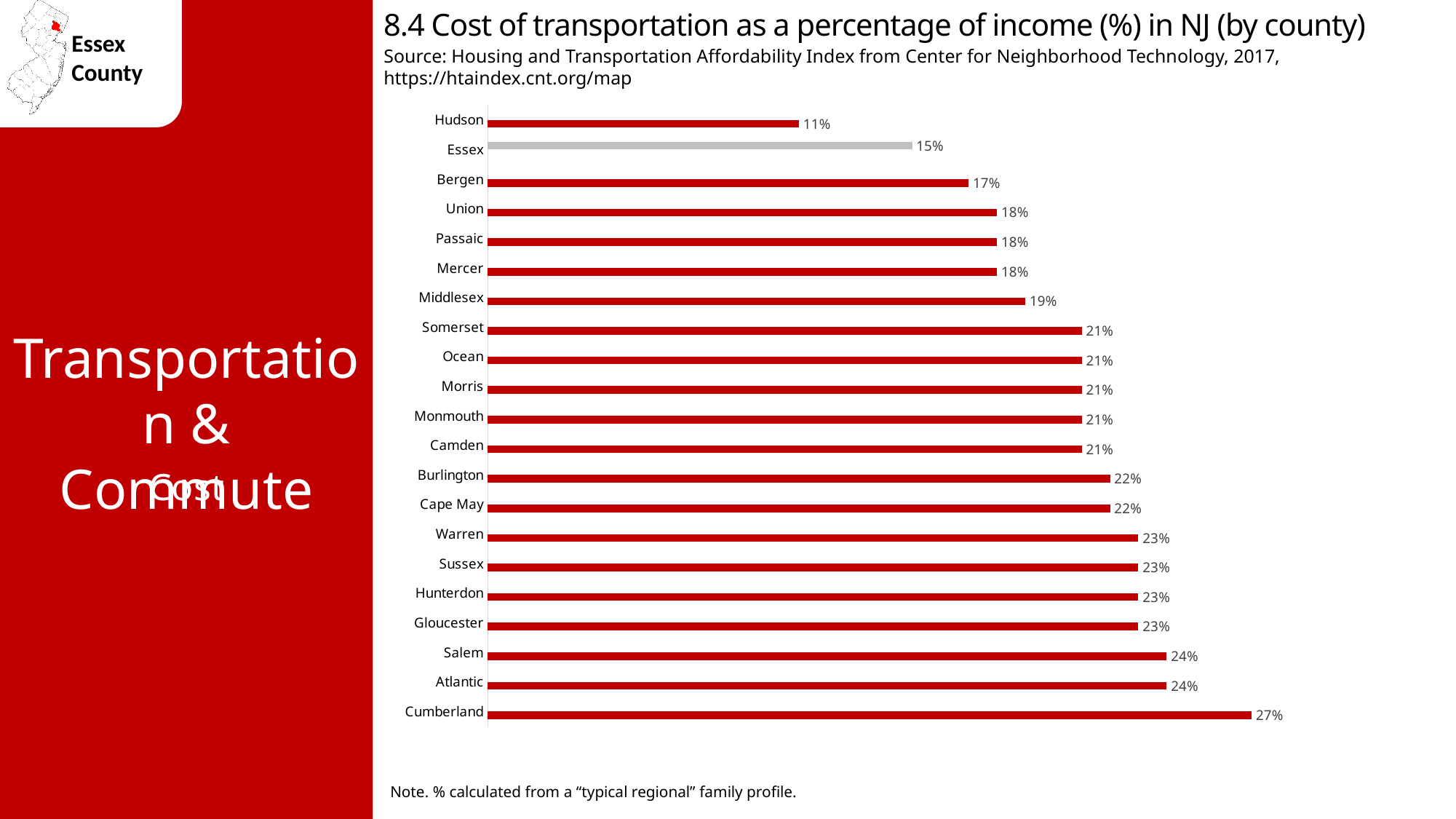
What is the difference between the values for Essex and Bergen? 2% How many counties are shown in the chart? 21 Which county has the highest cost of transportation as a percentage of income? Cumberland Which has a lower cost of transportation as a percentage of income, Essex or Union? Essex Which county's bar is shown in grey rather than red? Essex What is the cost of transportation as a percentage of income for Cumberland County? 27% What is the difference between the values for Cumberland and Hudson? 16% What is the value shown for Middlesex County? 19% Which county has the lowest cost of transportation as a percentage of income? Hudson Which has a higher cost of transportation as a percentage of income, Salem or Somerset? Salem What type of chart is shown on the slide? Bar chart What is the cost of transportation as a percentage of income for Essex County? 15%